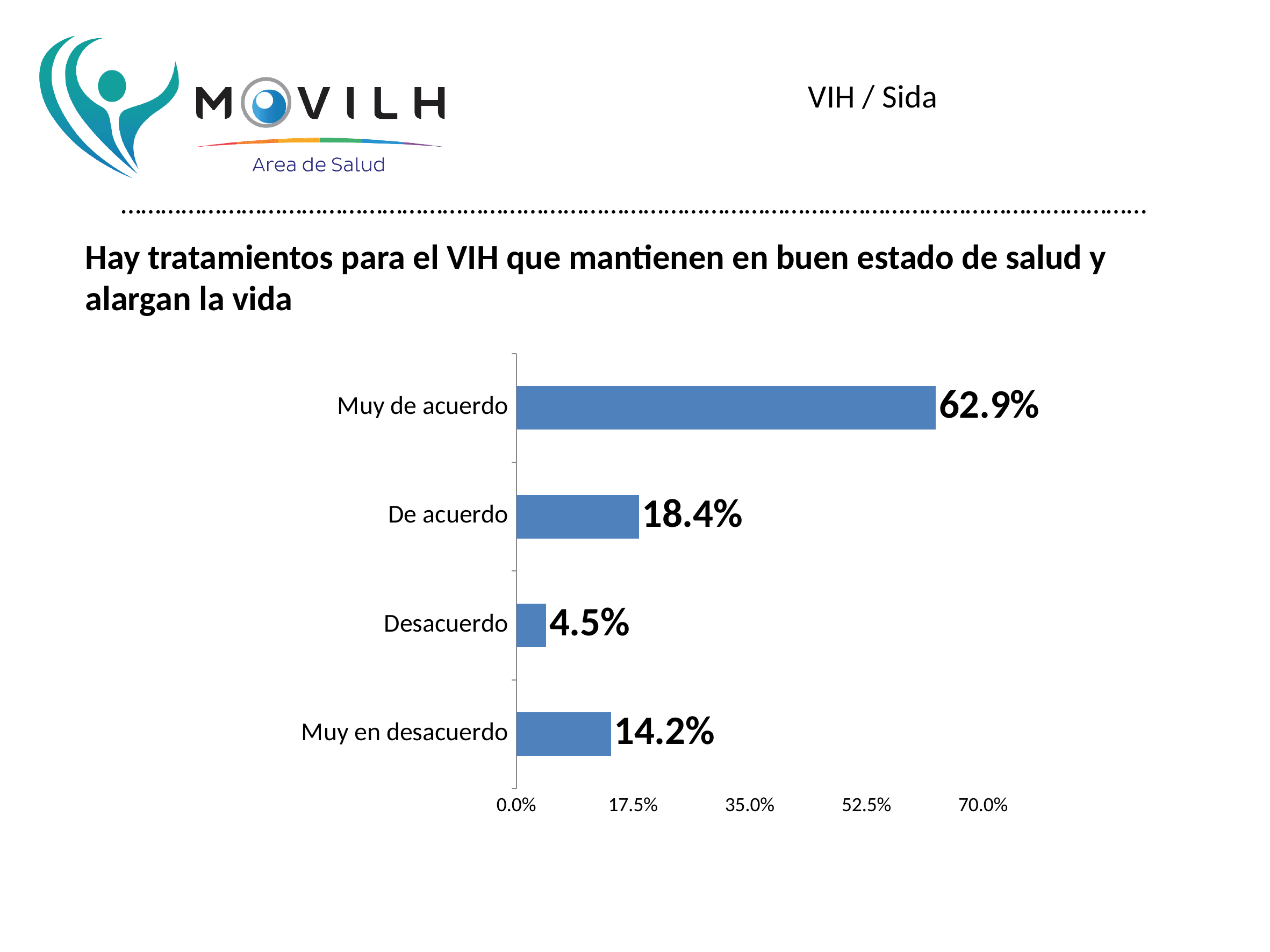
What is the highest tick label shown on the horizontal axis? 70.0% Which category has the lowest value? Desacuerdo Which is larger, the value for "De acuerdo" or the value for "Muy en desacuerdo"? De acuerdo Is the value for "Muy de acuerdo" greater or less than 52.5%? greater What is the value for "Muy de acuerdo"? 62.9% What is the value for "De acuerdo"? 18.4% What is the difference between the values for "Muy de acuerdo" and "De acuerdo"? 44.5% What kind of chart is shown on the slide? bar chart What is the value for "Desacuerdo"? 4.5% Which category has the highest value? Muy de acuerdo What is the value for "Muy en desacuerdo"? 14.2% How many categories are shown in the chart? 4